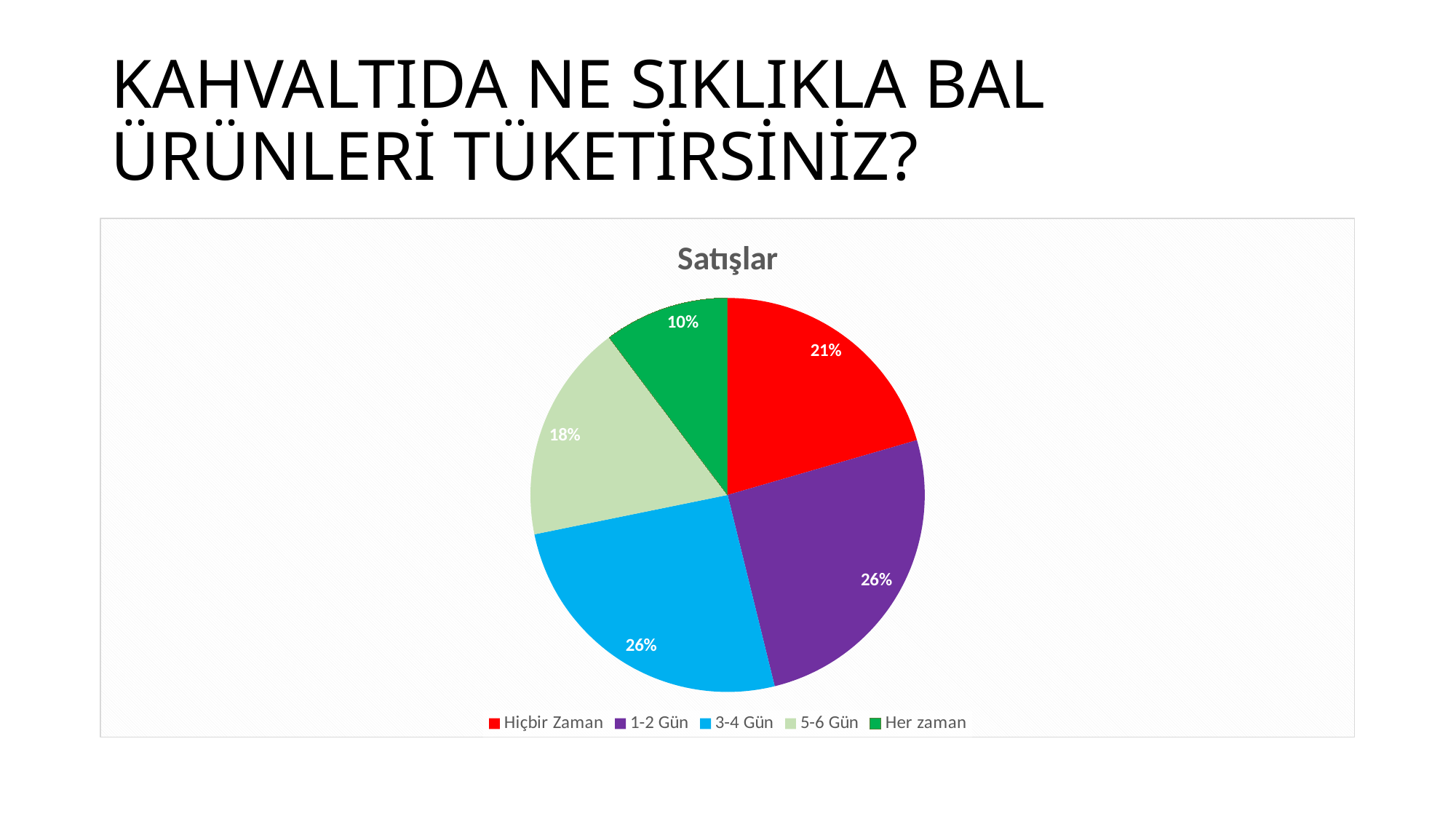
How many categories does the pie chart show? 5 What share of the pie does 1-2 Gün have? 26% Which is larger, the share for 5-6 Gün or the share for Hiçbir Zaman? Hiçbir Zaman Which category has the smallest slice? Her zaman What is the difference between the shares of 3-4 Gün and 5-6 Gün? 8% What is the difference between the shares of Hiçbir Zaman and Her zaman? 11% What is the chart's title? Satışlar What share of the pie does Hiçbir Zaman have? 21% Which colour represents 3-4 Gün in the legend? blue What kind of chart is shown on the slide? pie chart What share of the pie does 5-6 Gün have? 18%